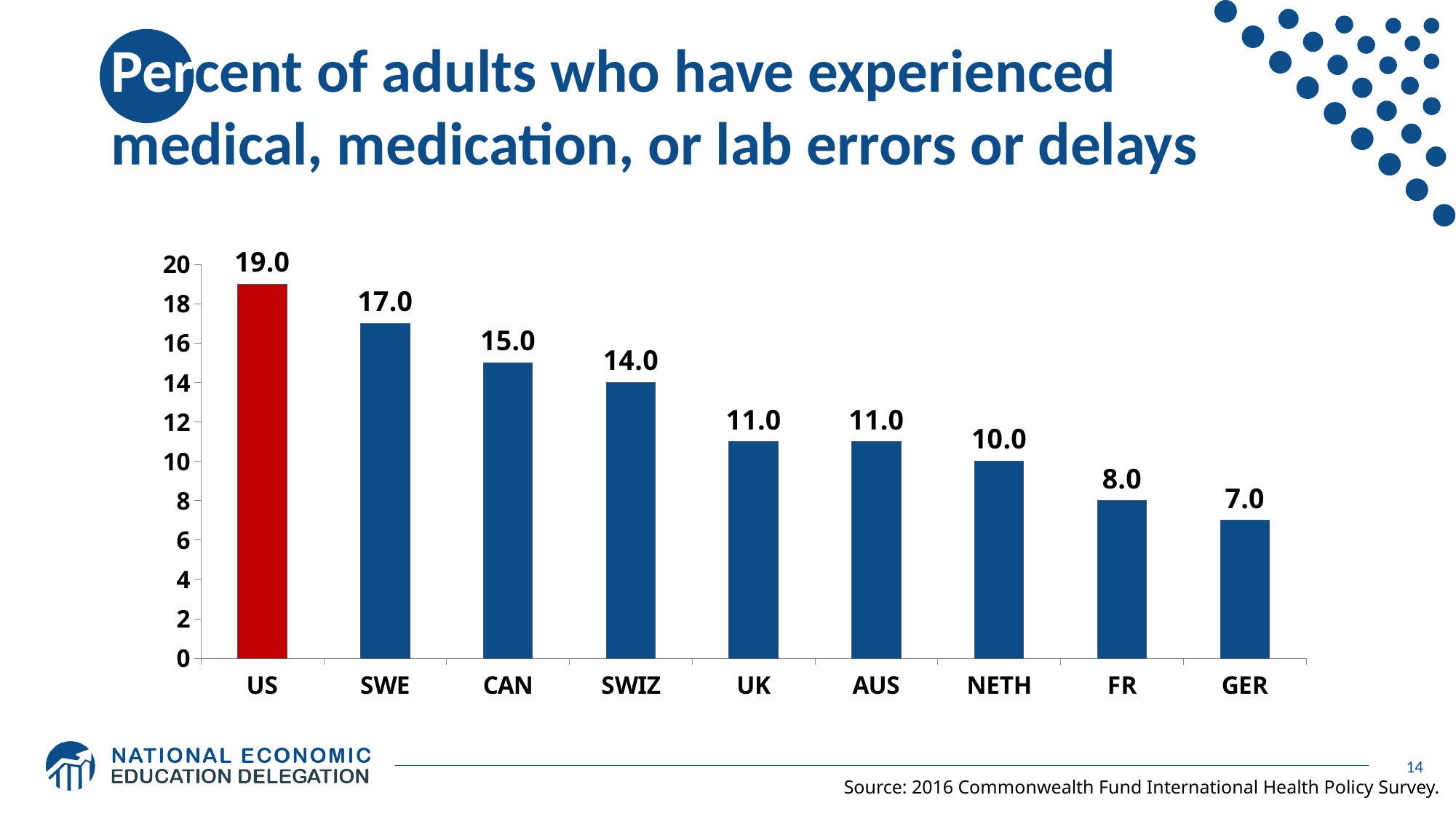
Which country has the lowest value? GER Which is larger, the value for FR or the value for NETH? NETH Which bar is coloured red rather than blue? US What kind of chart is shown on the slide? bar chart What is the value for SWIZ? 14.0 How many countries are shown on the chart? 9 What is the difference between the values for CAN and GER? 8.0 What is the value for NETH? 10.0 Which country has the highest value? US What is the value for the US? 19.0 What is the difference between the values for the US and SWE? 2.0 Is the value for SWE greater or less than 16? greater